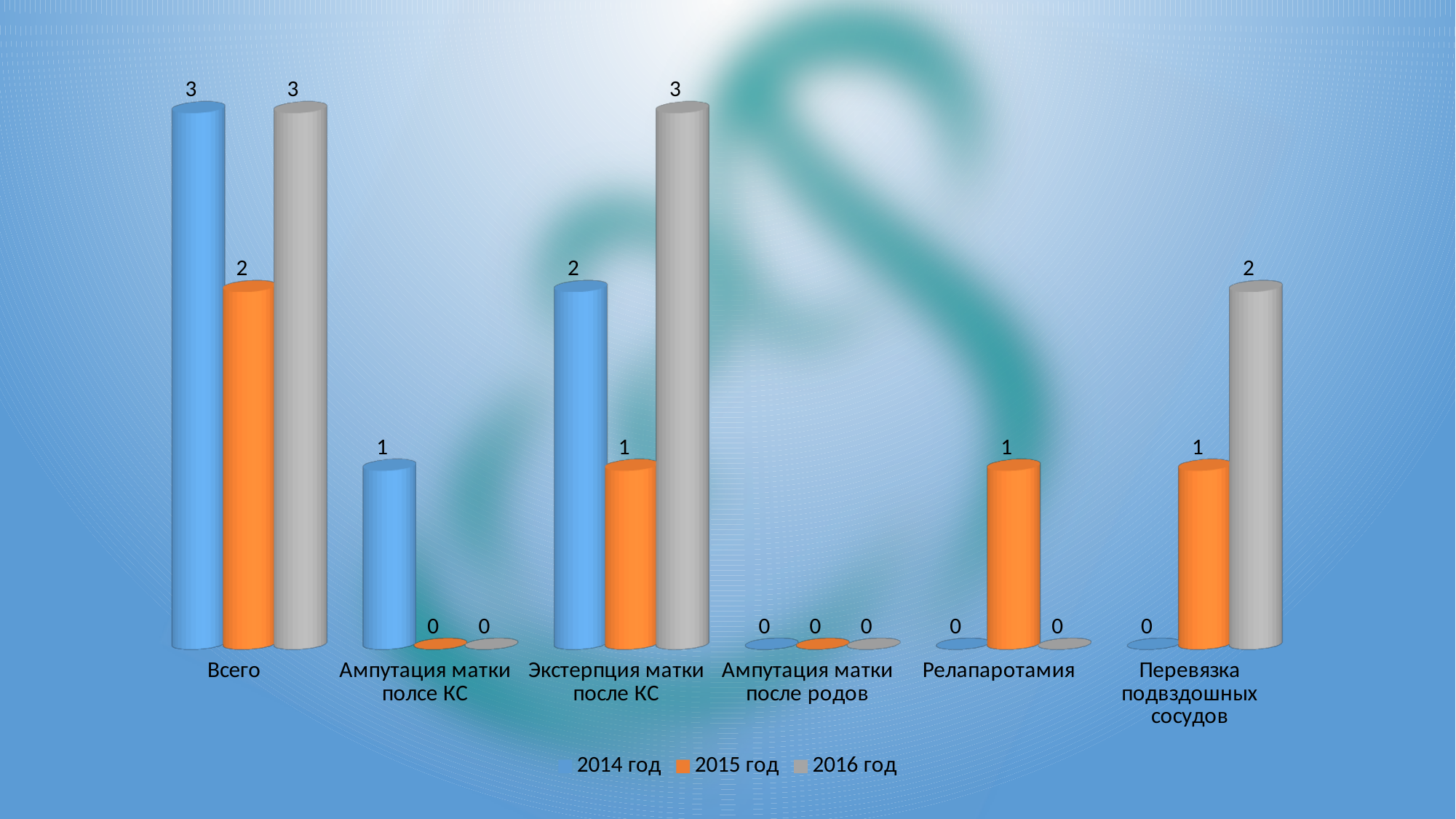
What is the value for "Всего" in the 2015 год series? 2 What is the value for "Релапаротамия" in the 2015 год series? 1 What kind of chart is shown on the slide? Bar chart What is the total of the three series values for "Ампутация матки после родов"? 0 What is the difference between the 2016 год and 2015 год values for "Экстерпция матки после КС"? 2 Which category has the highest value in the 2016 год series, excluding "Всего"? Экстерпция матки после КС How many series does the legend list? 3 How many categories are shown on the x axis? 6 What is the value for "Экстерпция матки после КС" in the 2016 год series? 3 What is the value for "Перевязка подвздошных сосудов" in the 2014 год series? 0 Which colour represents the 2015 год series in the legend? Orange Which is larger for "Перевязка подвздошных сосудов": the 2015 год value or the 2016 год value? 2016 год